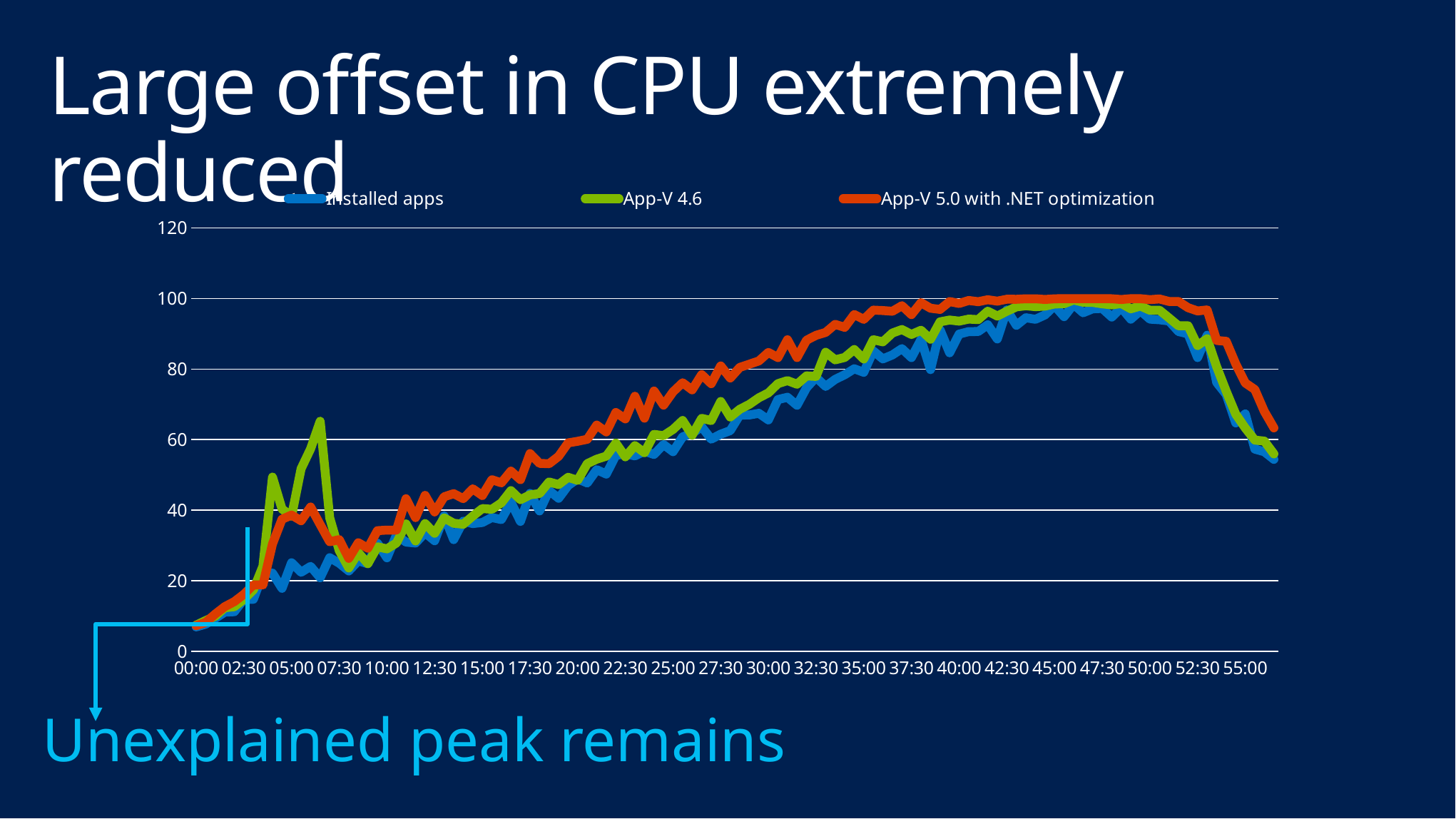
Which series shows the highest peak between 05:00 and 07:30? App-V 4.6 What are the three series named in the legend? Installed apps, App-V 4.6, App-V 5.0 with .NET optimization How many series does the legend list? 3 Do the values generally rise or fall along the x axis between 10:00 and 45:00? rise What kind of chart is shown on the slide? line chart At 25:00, which is higher: App-V 5.0 with .NET optimization or Installed apps? App-V 5.0 with .NET optimization Is the value for App-V 5.0 with .NET optimization at 45:00 greater or less than 80? greater What does the annotation below the chart say? Unexplained peak remains Is the value for Installed apps at 00:00 greater or less than 20? less How many time labels are shown on the x axis? 23 Is the value for App-V 4.6 at 55:00 greater or less than 80? less